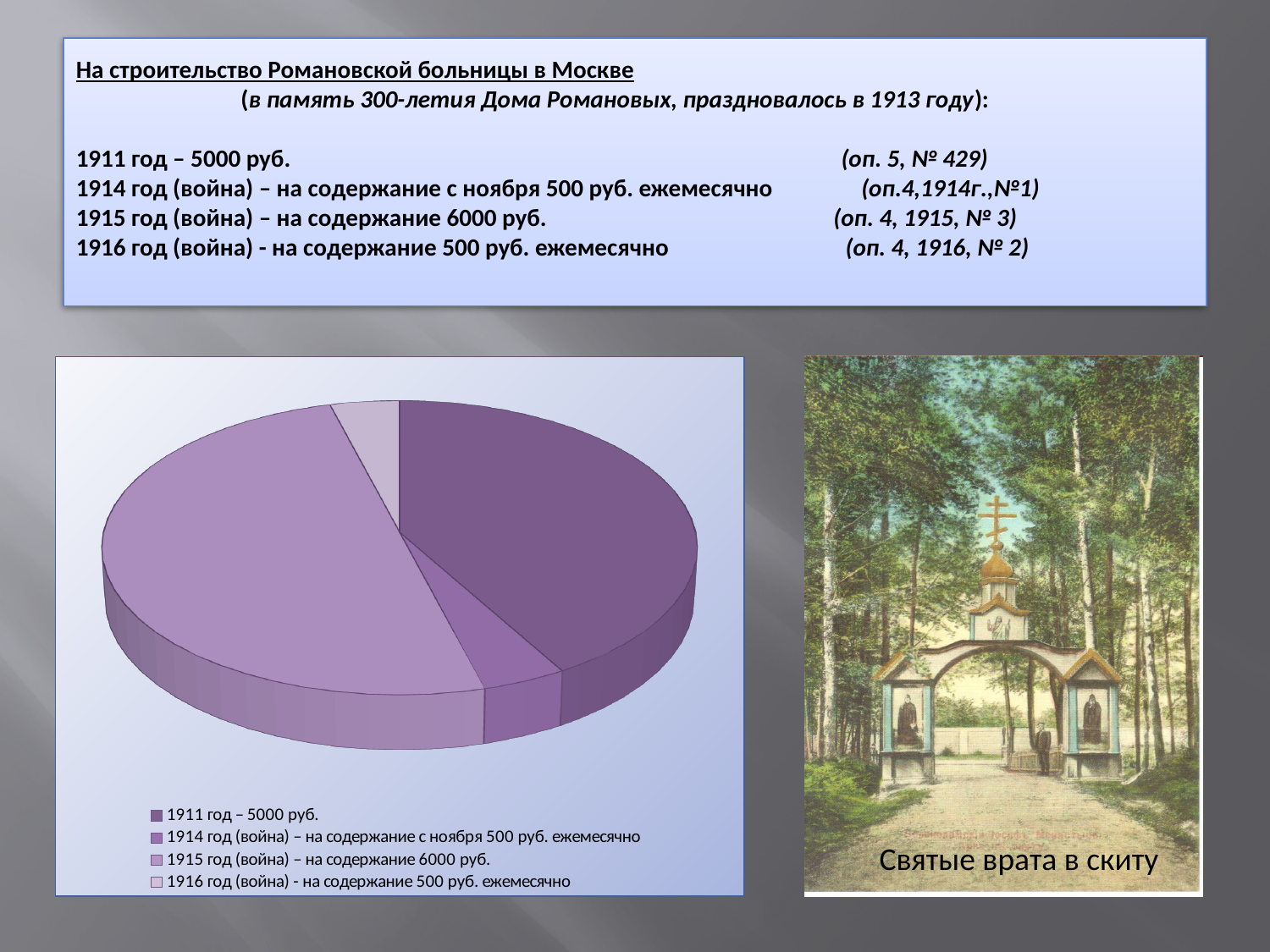
Which year does the darkest purple slice of the pie chart represent? 1911 год How many slices does the pie chart have? 4 According to the legend, what amount is given for 1915 год (война)? 6000 руб. What kind of chart is shown on the slide? pie chart According to the legend, what monthly amount is given for 1914 год (война)? 500 руб. ежемесячно Which legend entry is shown with the lightest colour in the pie chart? 1916 год (война) - на содержание 500 руб. ежемесячно How many entries does the legend of the pie chart list? 4 Which slice is larger in the pie chart: the one for 1915 год (война) or the one for 1916 год (война)? 1915 год (война) Which legend entry corresponds to the largest slice of the pie chart? 1915 год (война) – на содержание 6000 руб. Which slice is larger in the pie chart: the one for 1911 год or the one for 1914 год (война)? 1911 год According to the legend, what amount is given for 1911 год? 5000 руб.